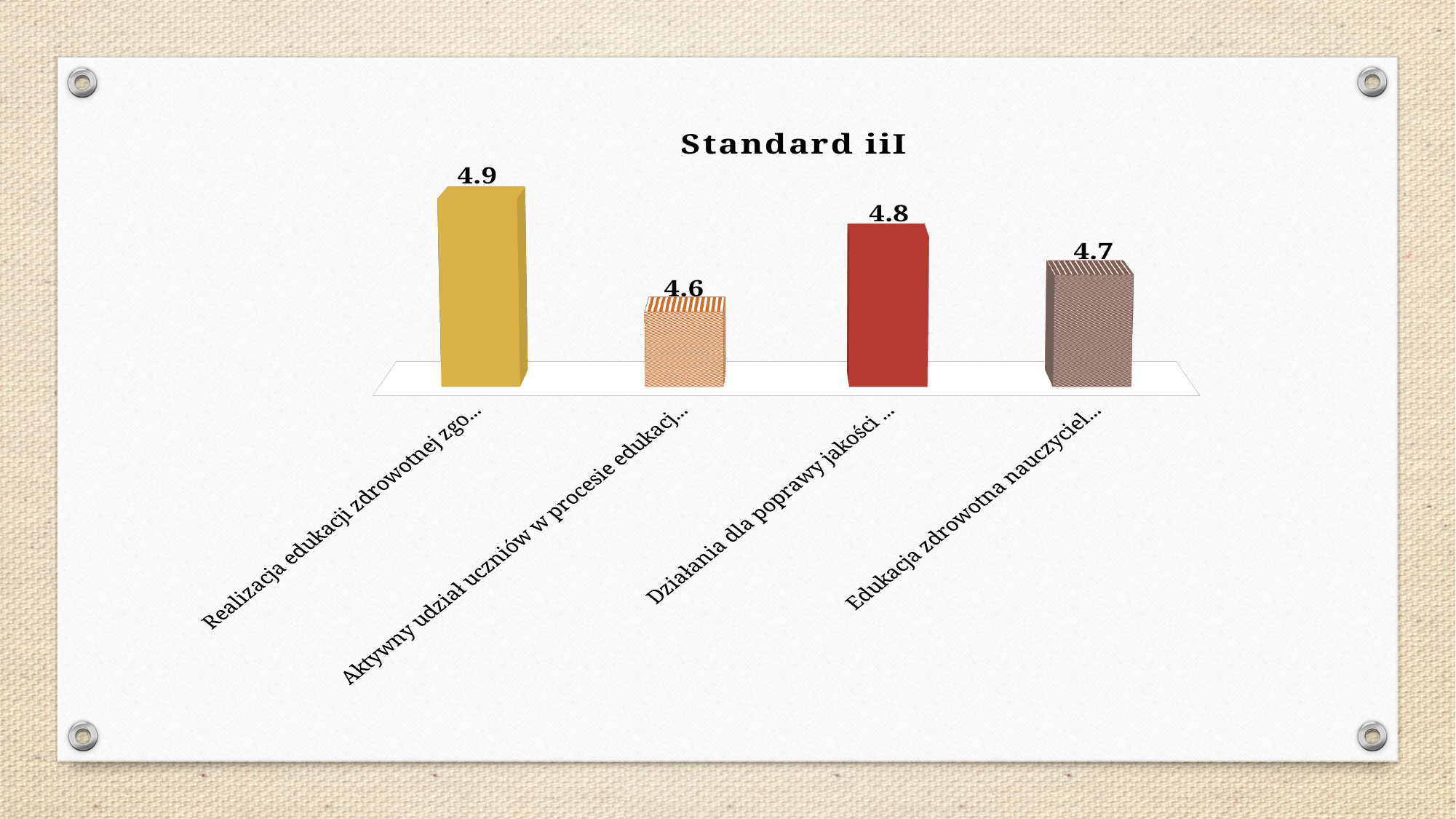
Which category has the lowest value? Aktywny udział uczniów w procesie edukacj... What is the value of the bar labelled "Aktywny udział uczniów w procesie edukacj..."? 4.6 Which category has the highest value? Realizacja edukacji zdrowotnej zgo... What is the title of the chart? Standard iiI What is the value of the bar labelled "Działania dla poprawy jakości ..."? 4.8 What is the value of the bar labelled "Realizacja edukacji zdrowotnej zgo..."? 4.9 How many bars are shown in the chart? 4 What is the value of the bar labelled "Edukacja zdrowotna nauczyciel..."? 4.7 What is the difference between the highest and lowest bar values? 0.3 What is the difference between the values for "Działania dla poprawy jakości ..." and "Edukacja zdrowotna nauczyciel..."? 0.1 What kind of chart is shown on the slide? Bar chart Which is larger: the value for "Działania dla poprawy jakości ..." or the value for "Aktywny udział uczniów w procesie edukacj..."? Działania dla poprawy jakości ...